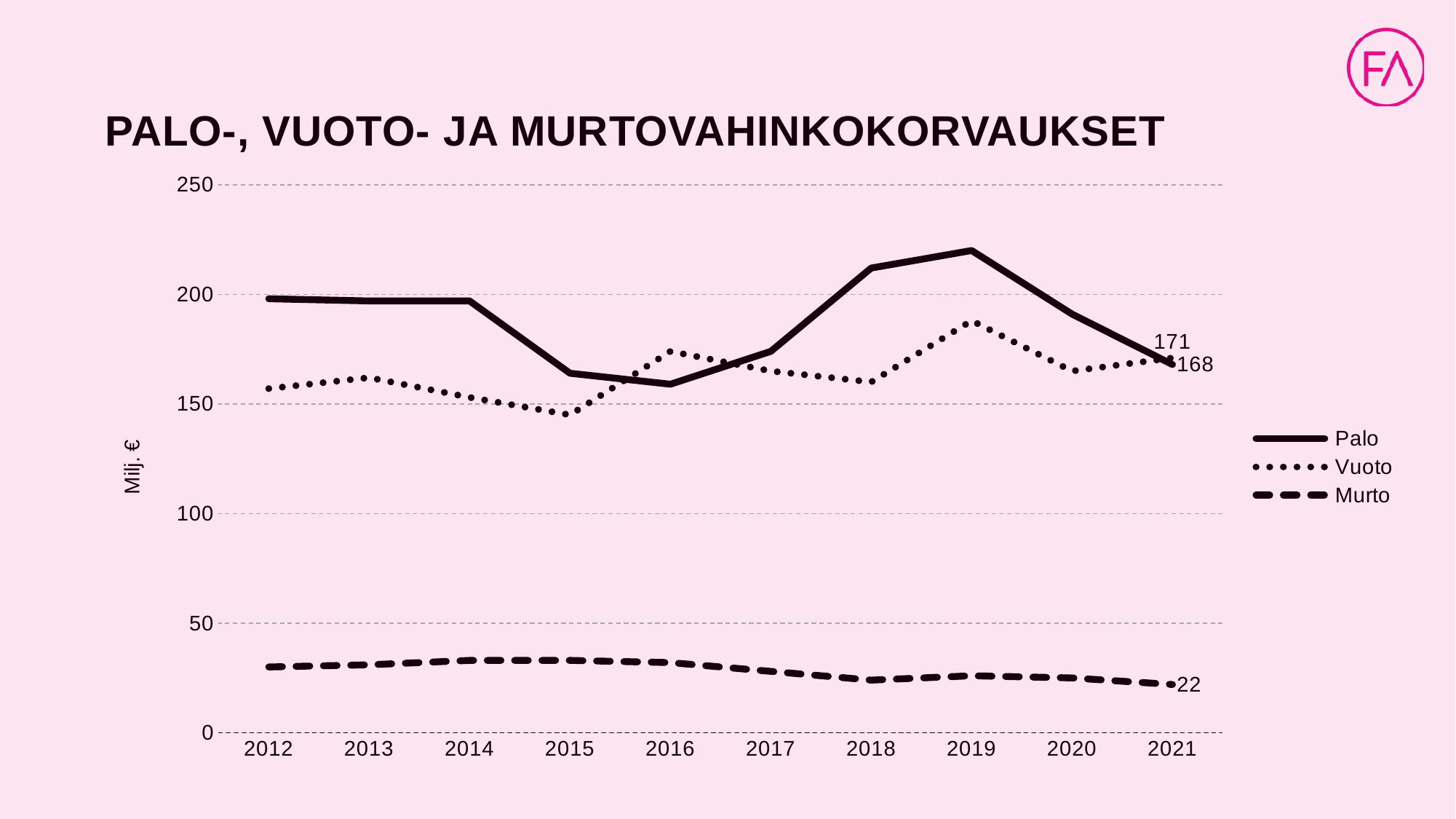
What is the difference between the Palo and Vuoto values in 2021? 3 How many years are plotted along the x axis? 10 What is the value for Murto in 2021? 22 What unit is shown on the y axis? Milj. € How many series does the legend list? 3 What is the value for Palo in 2021? 168 Which series has the larger value in 2021, Palo or Murto? Palo Does the Palo series rise or fall from 2019 to 2021? fall In which year does the Palo series reach its highest value? 2019 What is the value for Vuoto in 2021? 171 Is the value for Palo in 2019 greater or less than 200? greater What type of chart is shown on the slide? line chart